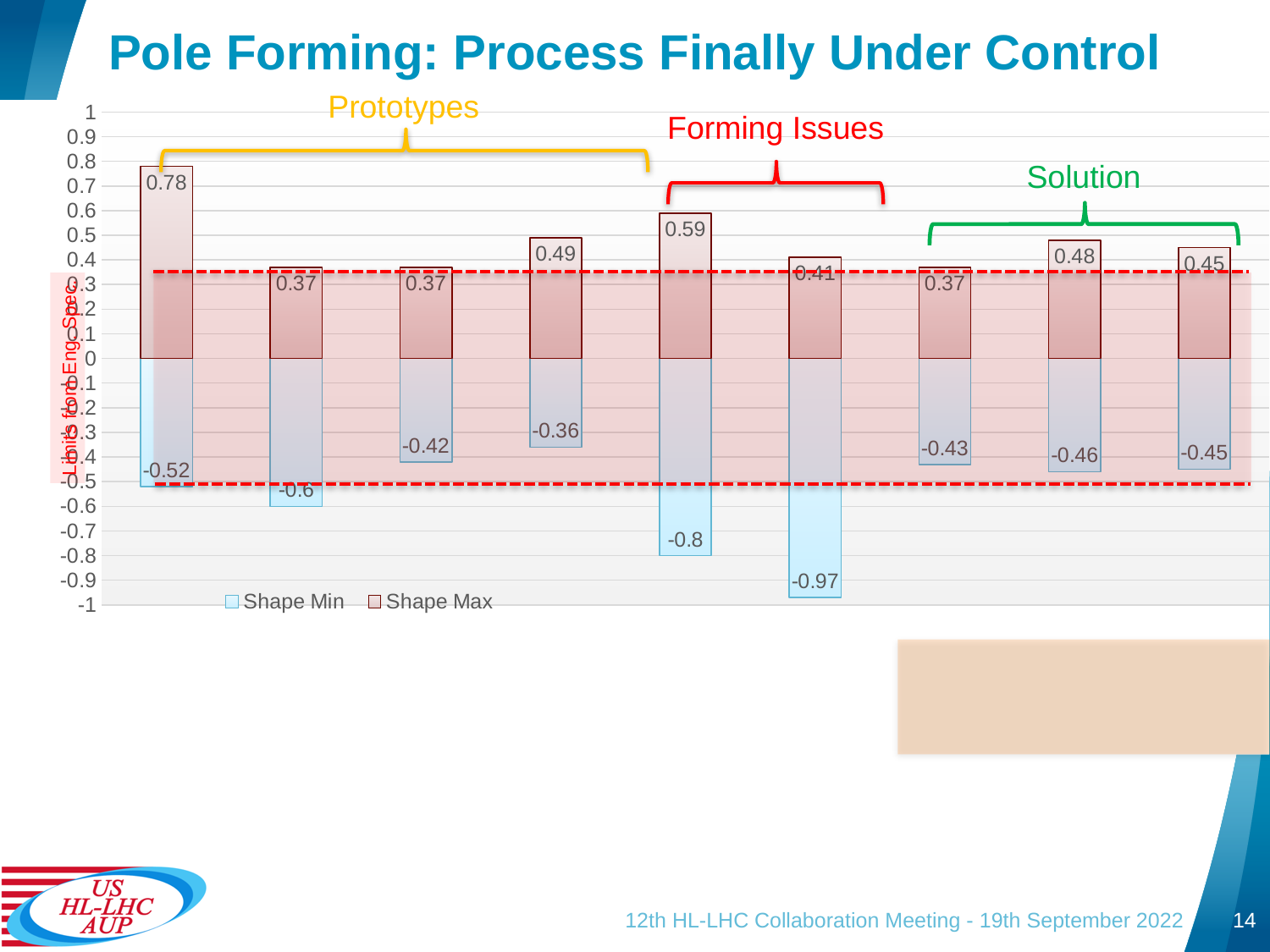
Which is larger in magnitude: the Shape Min of the second bar (-0.6) or the Shape Min of the third bar (-0.42)? The second bar (-0.6) What is the Shape Max value of the first (leftmost) bar? 0.78 Which group label is written in green above the rightmost three bars? Solution What is the Shape Min value of the fifth bar from the left? -0.8 What is the lowest Shape Min value shown in the chart? -0.97 What is the Shape Min value of the sixth bar from the left? -0.97 What kind of chart is shown on the slide? bar chart What is the difference between the Shape Max of the first bar (0.78) and the Shape Max of the fifth bar (0.59)? 0.19 How many Shape Max bars are plotted in the chart? 9 What are the two series named in the legend? Shape Min and Shape Max How many series does the legend list? 2 Which bar has the highest Shape Max value, and what is it? The first (leftmost) bar, 0.78